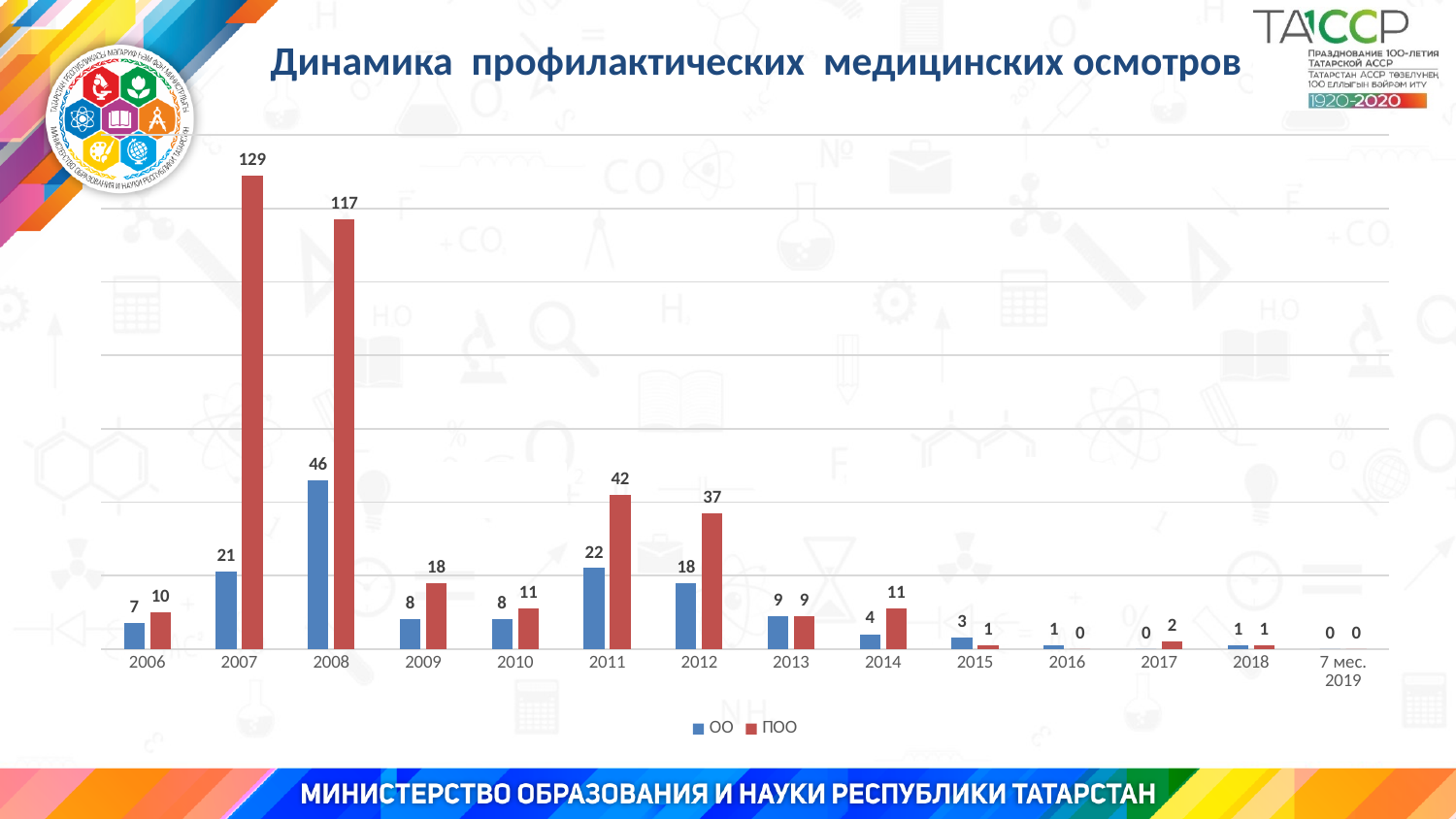
What is the title of the chart? Динамика профилактических медицинских осмотров What is the difference between the ПОО and ОО values in 2012? 19 How many series does the legend list? 2 Which year has the highest value for ОО? 2008 Which year has the highest value for ПОО? 2007 What kind of chart is shown on the slide? Bar chart Which series is shown in red in the legend? ПОО What is the value for ОО in 2008? 46 How many categories are shown on the x axis? 14 What is the value for ОО in 2011? 22 Which is larger in 2015, the ОО value or the ПОО value? ОО What is the value for ПОО in 2007? 129